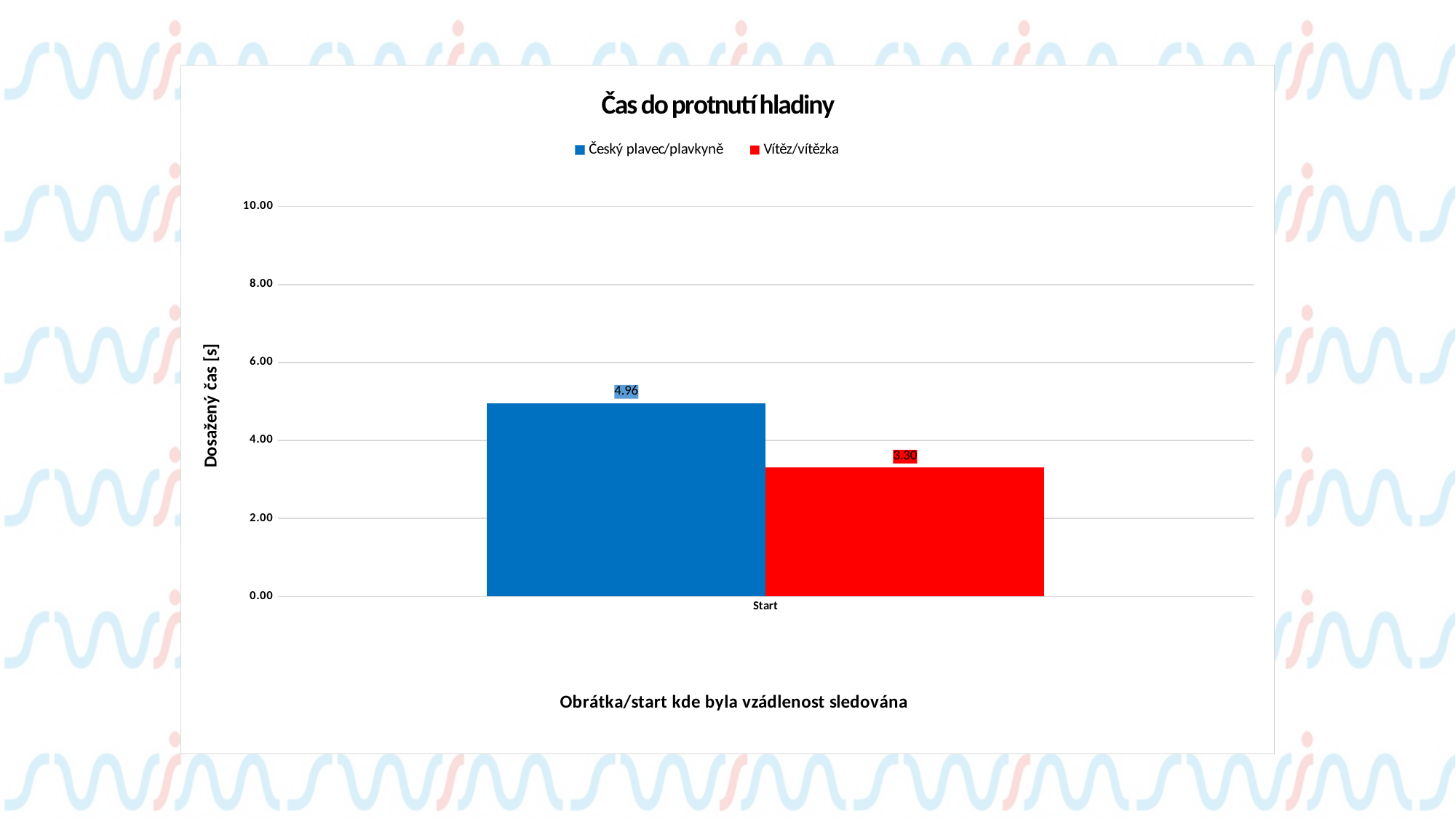
What kind of chart is shown? bar chart What is the difference between the Český plavec/plavkyně and Vítěz/vítězka values at Start? 1.66 What is the value for Český plavec/plavkyně at Start? 4.96 Which series has the lowest value on the chart? Vítěz/vítězka What is the value for Vítěz/vítězka at Start? 3.30 Which series has the higher value at Start? Český plavec/plavkyně What is the label of the y axis? Dosažený čas [s] Is the value for Vítěz/vítězka at Start greater or less than 4.00? less How many series does the legend list? 2 How many categories are shown on the x axis? 1 What is the title of the chart? Čas do protnutí hladiny Is the value for Český plavec/plavkyně at Start greater or less than 4.00? greater